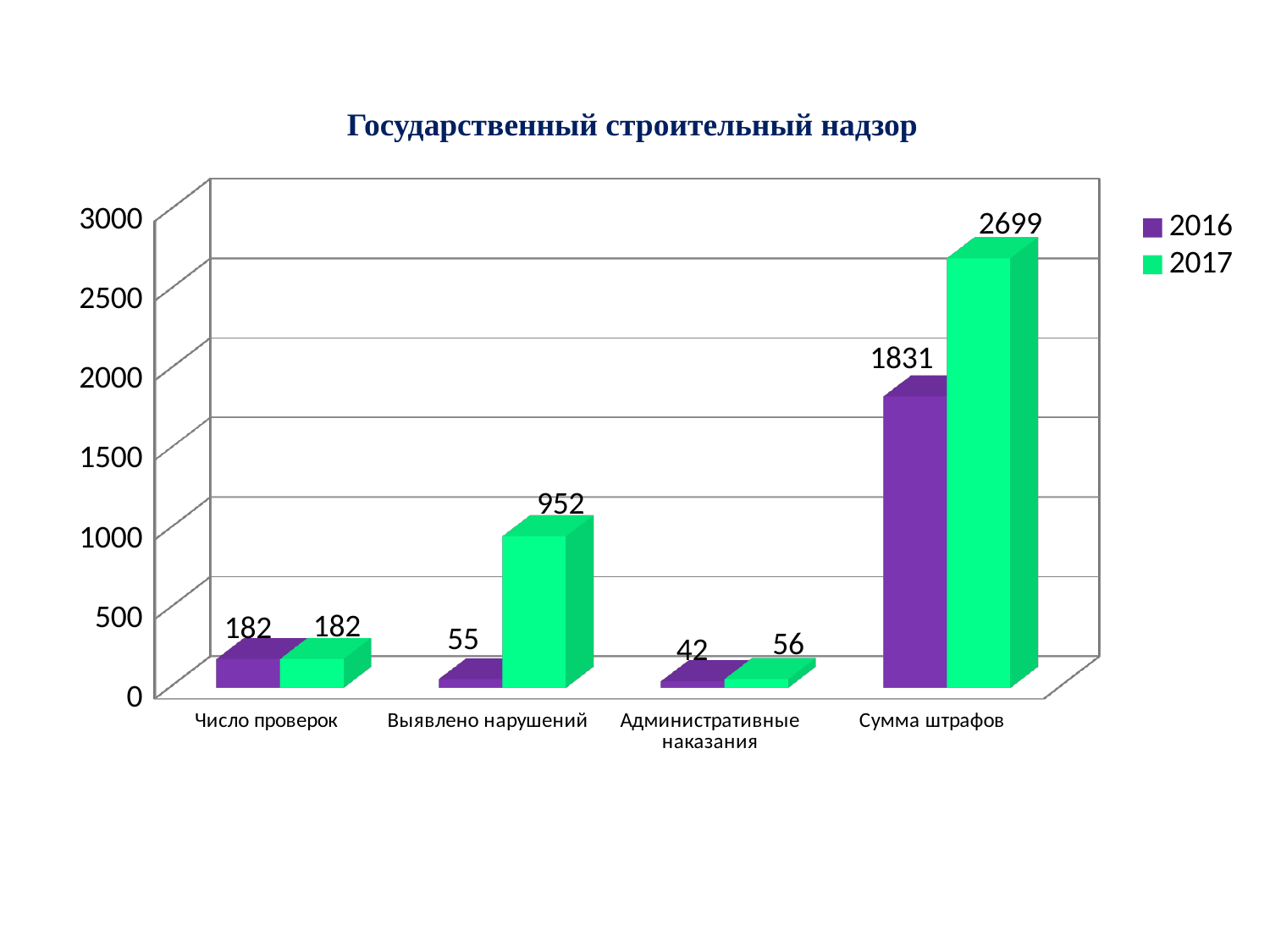
How many categories are shown on the x axis? 4 What is the value for Выявлено нарушений in 2016? 55 What is the difference between the 2017 and 2016 values for Сумма штрафов? 868 What is the difference between the 2017 and 2016 values for Выявлено нарушений? 897 Which category has the highest value for 2016? Сумма штрафов Which is larger for Административные наказания, the 2016 value or the 2017 value? 2017 What is the value for Административные наказания in 2017? 56 Which category has the lowest value for 2017? Административные наказания Is the 2016 value for Сумма штрафов greater or less than 2000? less What kind of chart is shown on the slide? bar chart How many series does the legend list? 2 What is the value for Сумма штрафов in 2017? 2699